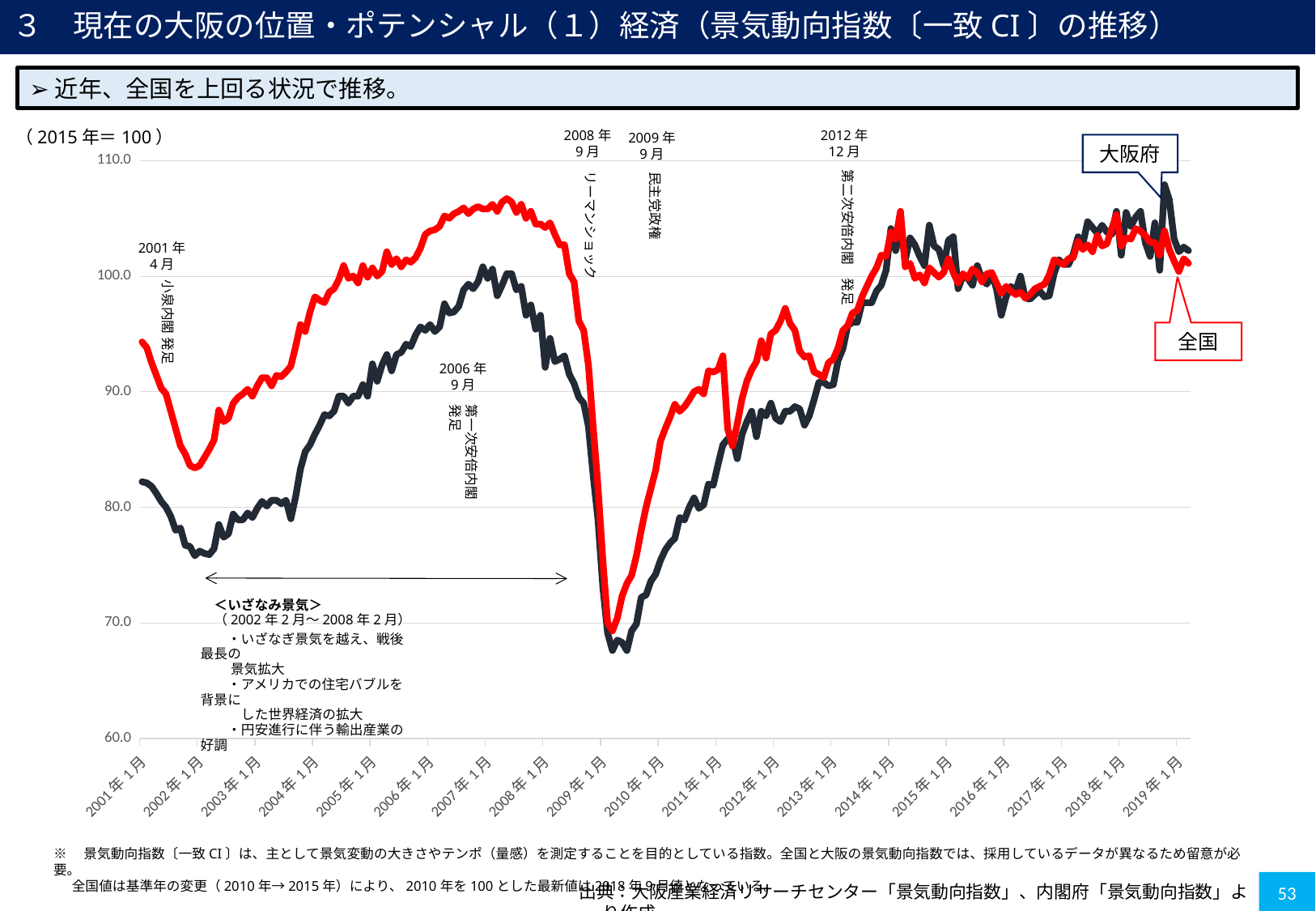
How many year labels are shown on the x axis? 19 Between 2008年1月 and 2009年1月, do the values for 大阪府 rise or fall? fall Is the value for 大阪府 at 2001年1月 greater or less than 80? greater At 2001年1月, which series has the higher value, 大阪府 or 全国? 全国 What kind of chart is shown on the slide? line chart Is the value for 大阪府 at 2002年1月 greater or less than 80? less Which series is drawn in red? 全国 What base year is the index set to 100, according to the note above the chart? 2015年 Is the value for 全国 at 2001年1月 greater or less than 90? greater How many series does the chart show? 2